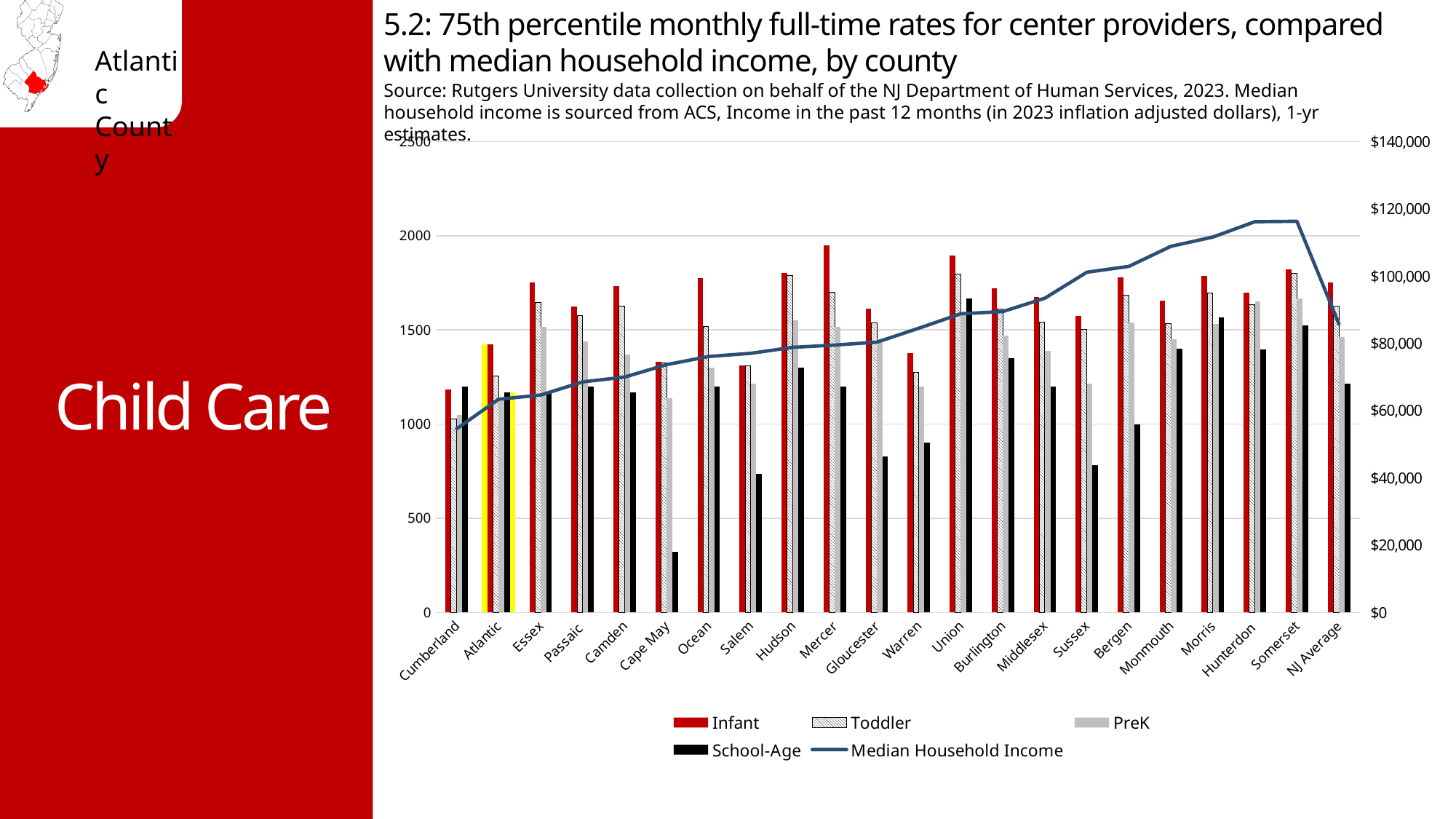
Is the School-Age value for Union greater or less than 1500? greater What kind of chart is shown on the slide? A combined bar and line chart Is the School-Age value for Cape May greater or less than 500? less Does the Median Household Income line generally rise or fall from Cumberland to Somerset? rise Is the Infant value for Mercer greater or less than 1500? greater Which is larger, the Infant rate for Mercer or the Infant rate for Cumberland? Mercer Which county has the lowest School-Age rate? Cape May Which county's bars are highlighted in yellow on the chart? Atlantic How many categories are shown along the x axis? 22 How many series does the legend list? 5 Which county has the lowest Infant rate? Cumberland